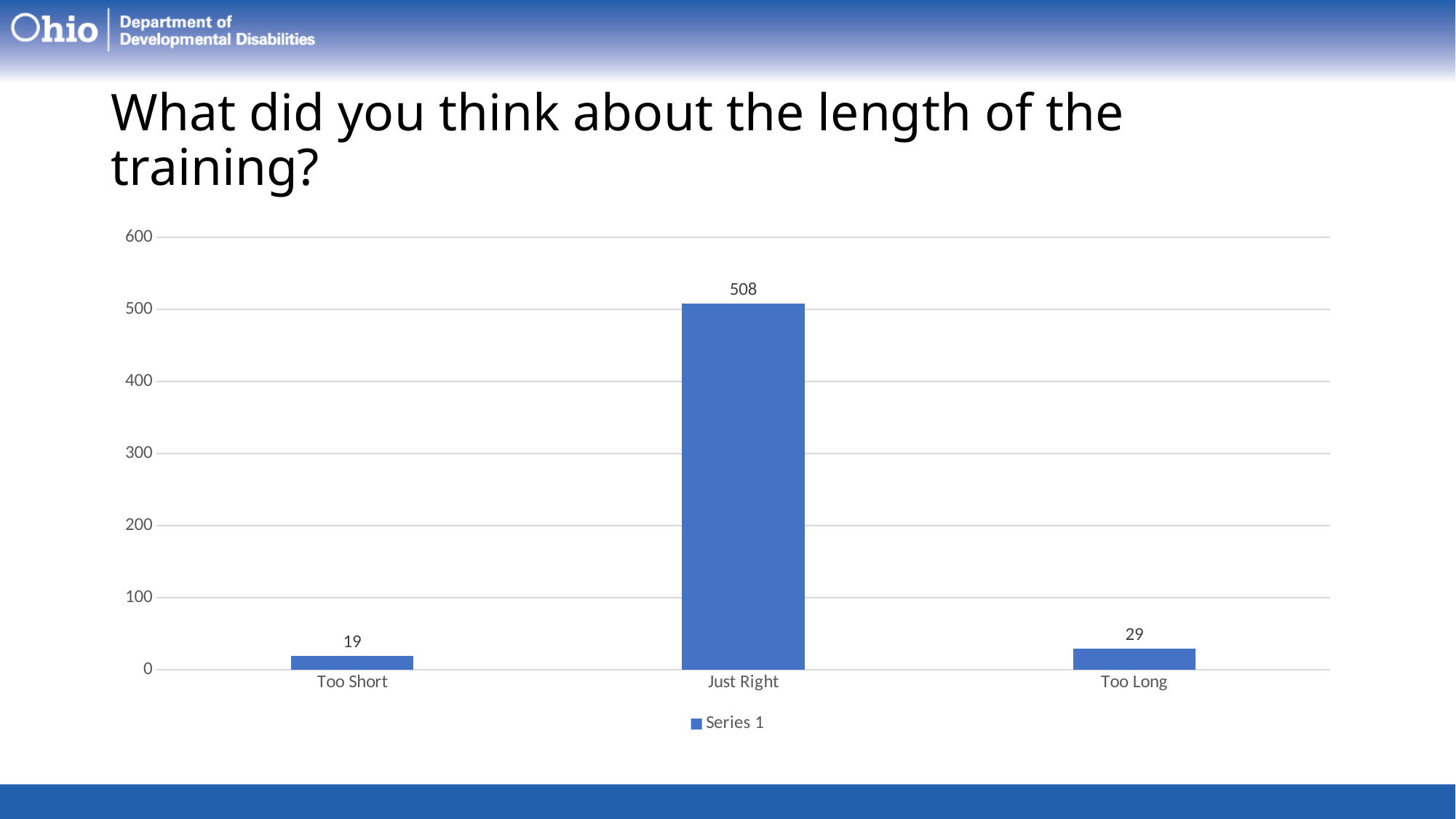
How many categories are shown on the x axis? 3 What is the value for Too Long? 29 Is the value for Just Right greater or less than 500? greater Which is larger, the value for Too Long or the value for Too Short? Too Long What is the difference between the values for Too Long and Too Short? 10 What is the value for Just Right? 508 Which category has the lowest value? Too Short What is the value for Too Short? 19 What kind of chart is shown on the slide? bar chart How many series does the legend list? 1 What is the difference between the values for Just Right and Too Long? 479 Which category has the highest value? Just Right